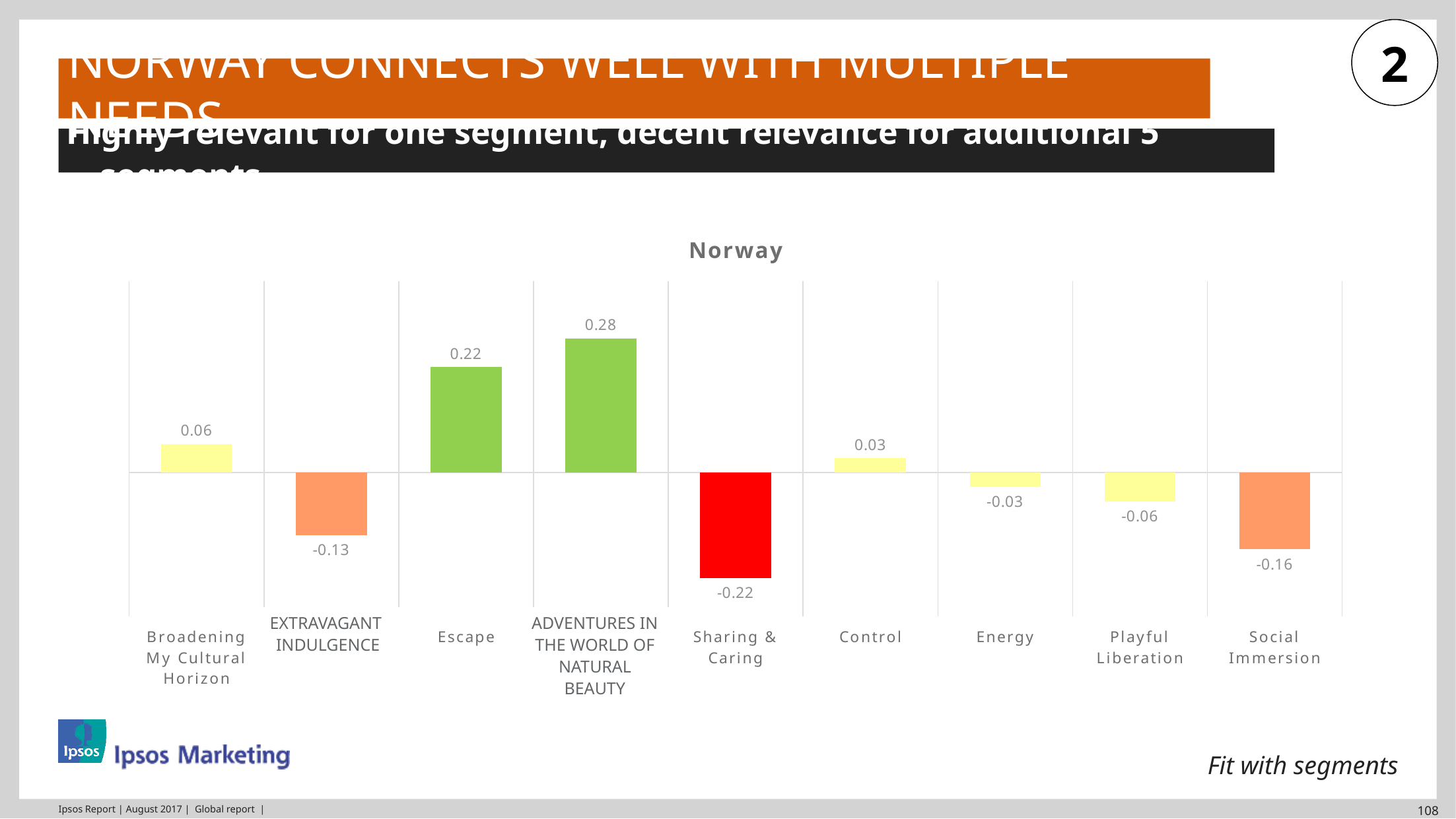
What colour is the bar for Sharing & Caring? Red What is the value for Extravagant Indulgence in the Norway chart? -0.13 What is the value for Sharing & Caring in the Norway chart? -0.22 Which is larger, the value for Broadening My Cultural Horizon or the value for Control? Broadening My Cultural Horizon What is the value for Social Immersion in the Norway chart? -0.16 What is the difference between the values for Adventures in the World of Natural Beauty and Escape? 0.06 What is the value for Escape in the Norway chart? 0.22 Which category has the lowest value in the Norway chart? Sharing & Caring Which category has the highest value in the Norway chart? Adventures in the World of Natural Beauty How many categories are shown in the Norway chart? 9 What is the title of the chart? Norway What kind of chart is shown on the slide? Bar chart